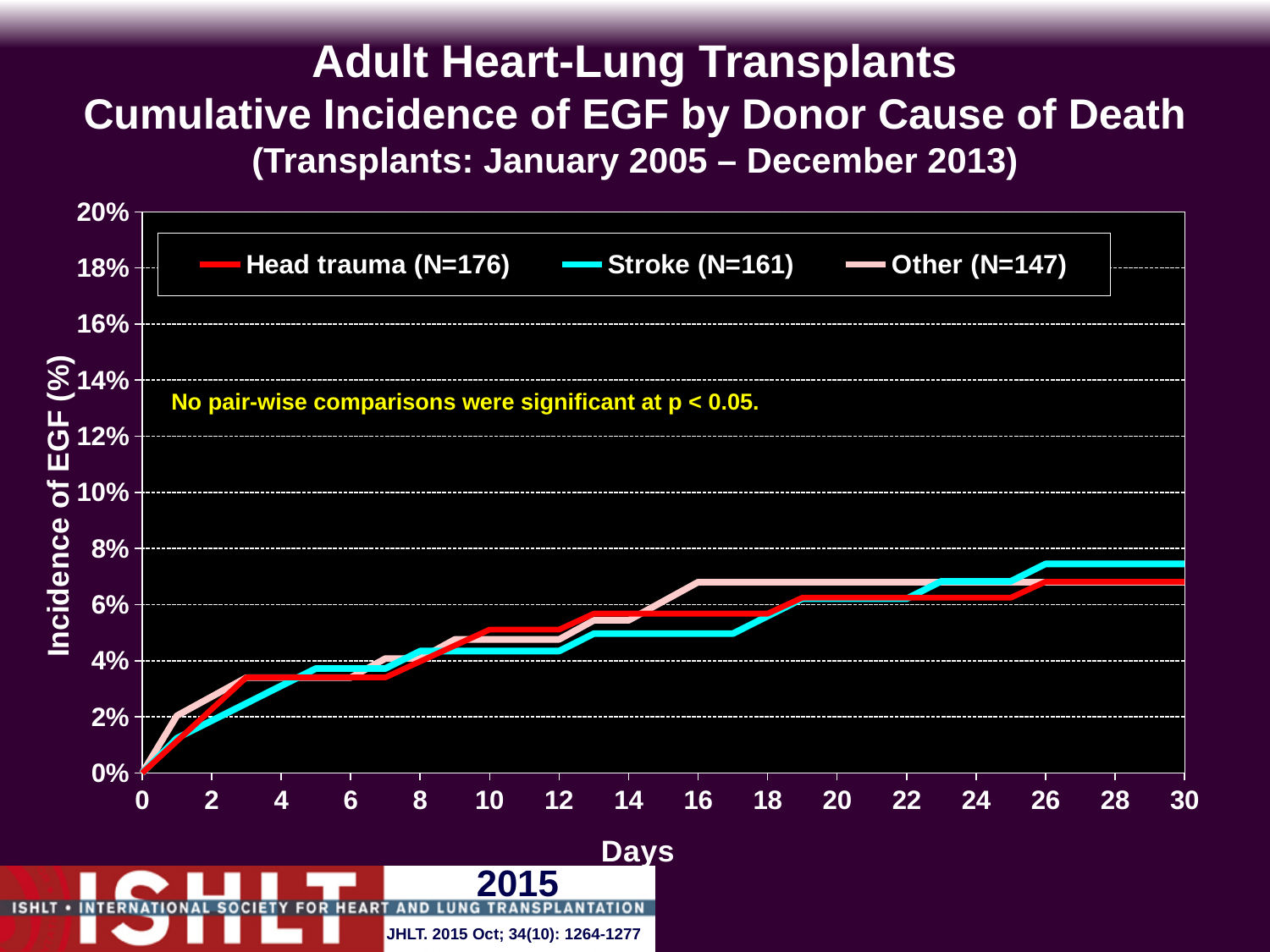
Which series has the highest cumulative incidence of EGF at day 30? Stroke (N=161) What is the label of the x axis? Days How many series does the legend list? 3 Is the value for Stroke at day 30 greater or less than 8%? less Is the value for Stroke at day 30 greater or less than 6%? greater Is the value for Other at day 16 greater or less than 6%? greater What kind of chart is shown on the slide? Line chart What is the N for the Head trauma series in the legend? N=176 Do the cumulative incidence values rise or fall as days increase? Rise